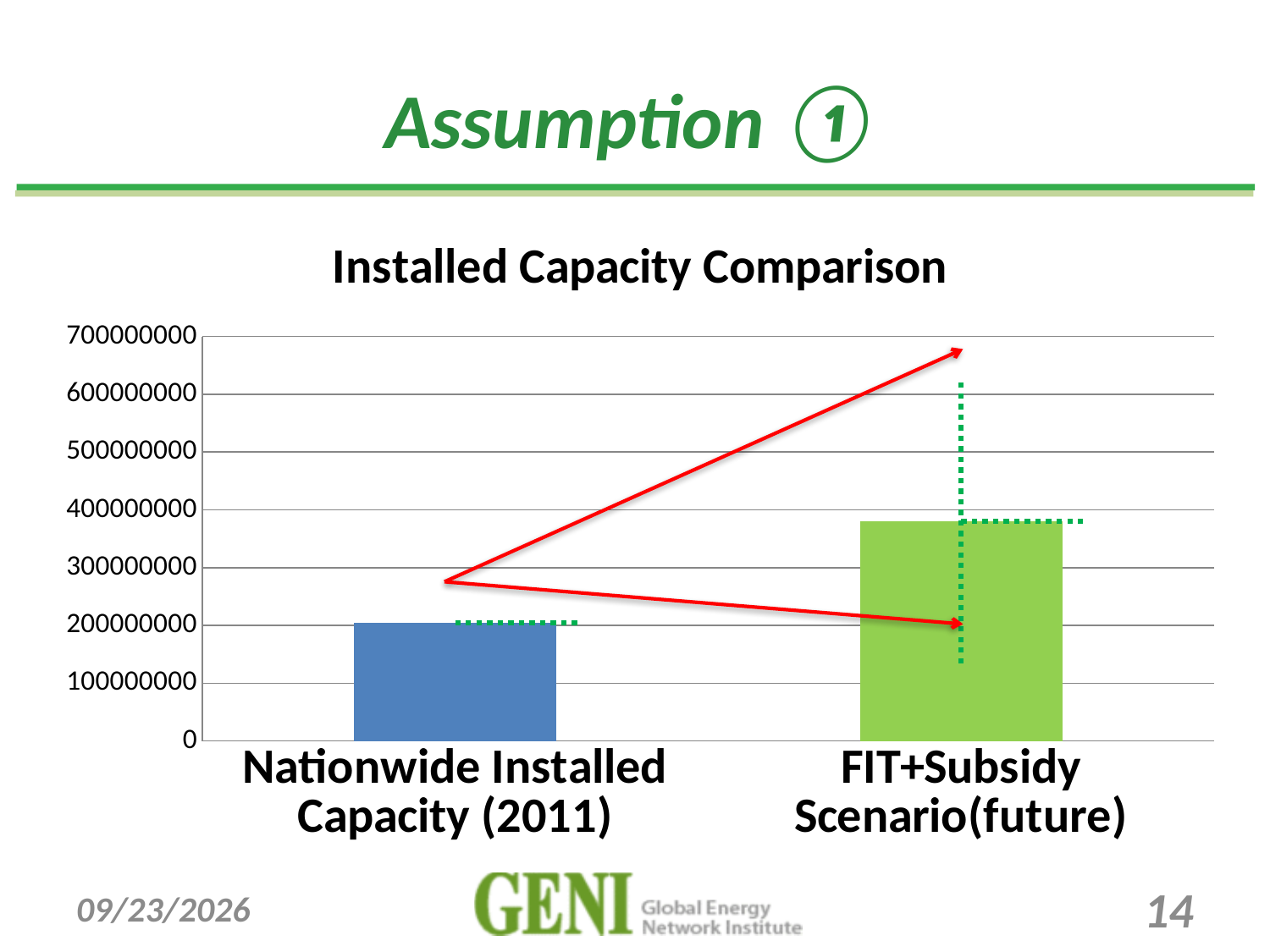
Is the value for Nationwide Installed Capacity (2011) greater or less than 100000000? greater Is the value for Nationwide Installed Capacity (2011) greater or less than 300000000? less What is the title of the chart? Installed Capacity Comparison What type of chart is shown on the slide? bar chart Which is larger, the value for Nationwide Installed Capacity (2011) or the value for FIT+Subsidy Scenario(future)? FIT+Subsidy Scenario(future) Do the values rise or fall from left to right along the x axis? rise How many categories are plotted in the chart? 2 Which category has the highest value? FIT+Subsidy Scenario(future) What colour is the bar for FIT+Subsidy Scenario(future)? green Which category has the lowest value? Nationwide Installed Capacity (2011) Is the value for FIT+Subsidy Scenario(future) greater or less than 400000000? less